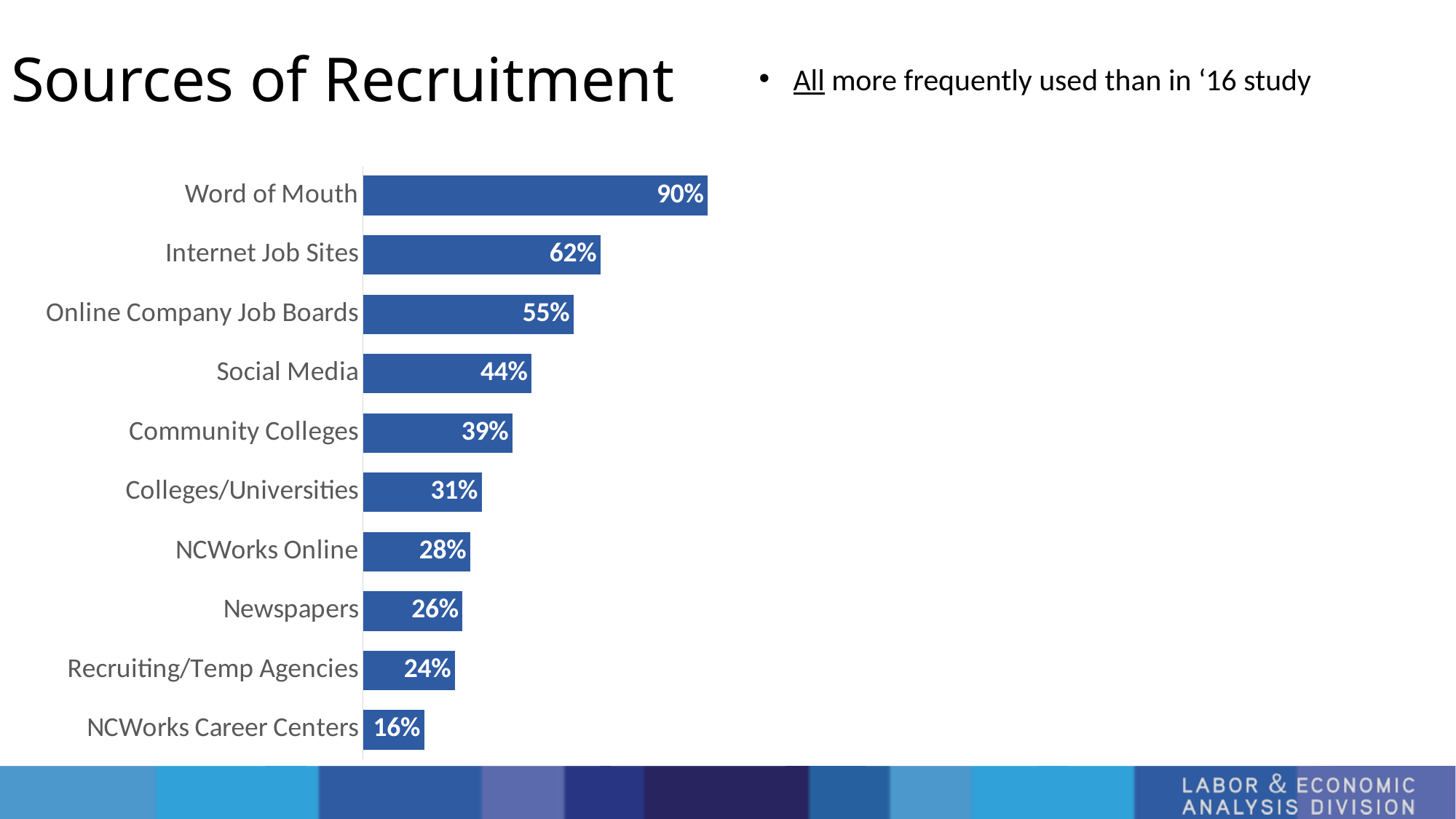
How many sources of recruitment are shown in the chart? 10 Which is larger, the value for Newspapers or the value for Recruiting/Temp Agencies? Newspapers Which is larger, the value for Community Colleges or the value for Colleges/Universities? Community Colleges What kind of chart is shown on the slide? Bar chart Which source of recruitment has the lowest value? NCWorks Career Centers Which source of recruitment has the highest value? Word of Mouth What percentage is shown for Word of Mouth? 90% What is the value for Social Media? 44% What percentage is shown for NCWorks Online? 28% What is the difference between the values for Word of Mouth and NCWorks Career Centers? 74% What is the title of the slide containing the chart? Sources of Recruitment What is the difference between the values for Internet Job Sites and Online Company Job Boards? 7%